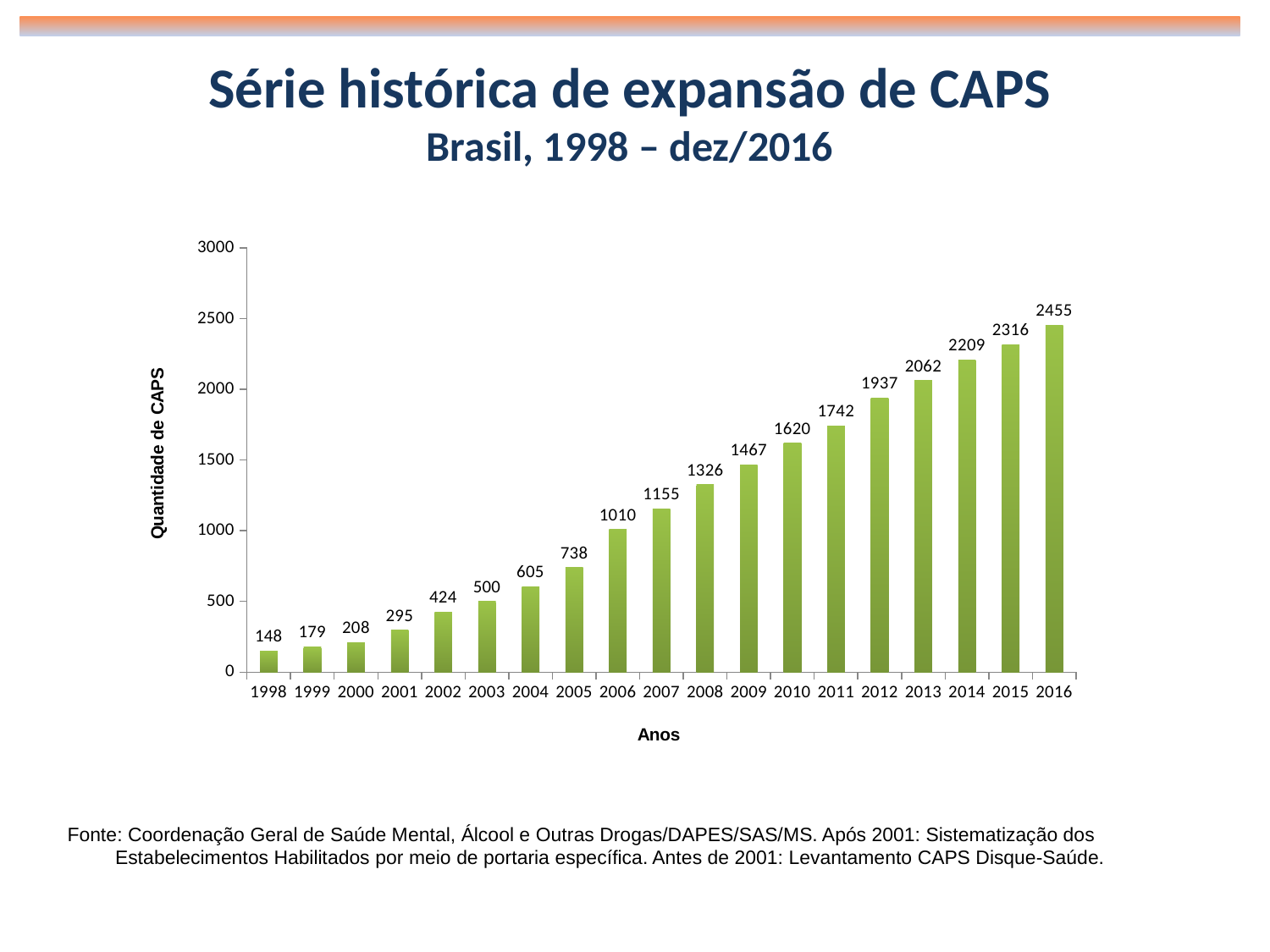
What is the number of CAPS in 1998? 148 How many years are shown on the x axis? 19 Do the values rise or fall from 1998 to 2016? rise Which year has the lowest number of CAPS? 1998 Which year has the highest number of CAPS? 2016 What is the difference between the number of CAPS in 2010 and in 2005? 882 What is the number of CAPS in 2006? 1010 Which year has more CAPS, 2003 or 2008? 2008 Is the value for 2011 greater or less than 1500? greater What is the number of CAPS in 2013? 2062 What is the difference between the number of CAPS in 2016 and in 2015? 139 What kind of chart is shown on the slide? bar chart